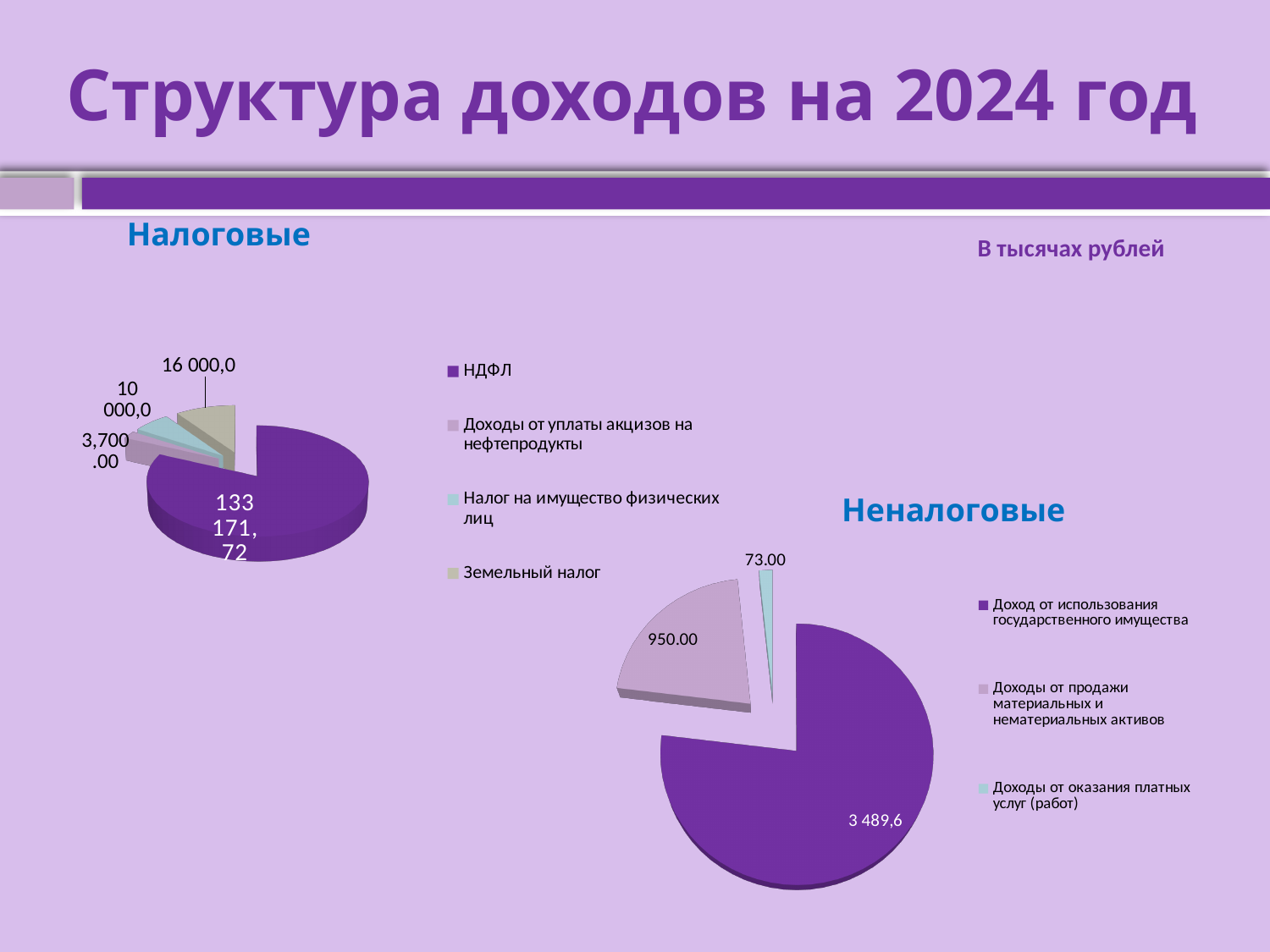
In the "Налоговые" chart, what is the value for Доходы от уплаты акцизов на нефтепродукты? 3,700.00 In the "Неналоговые" chart, which category has the smallest slice? Доходы от оказания платных услуг (работ) In the "Неналоговые" chart, what is the value for Доходы от оказания платных услуг (работ)? 73.00 In the "Неналоговые" chart, which is larger: Доход от использования государственного имущества or Доходы от продажи материальных и нематериальных активов? Доход от использования государственного имущества In the "Налоговые" chart, which category has the largest slice? НДФЛ In the "Неналоговые" chart, what is the value for Доход от использования государственного имущества? 3 489,6 In the "Налоговые" chart, what is the value for Земельный налог? 16 000,0 In the "Неналоговые" chart, what is the difference between Доходы от продажи материальных и нематериальных активов and Доходы от оказания платных услуг (работ)? 877.00 How many categories does the legend of the "Налоговые" chart list? 4 What kind of chart is the "Налоговые" chart? pie chart In the "Налоговые" chart, what is the value for НДФЛ? 133 171,72 How many slices does the "Неналоговые" pie chart have? 3